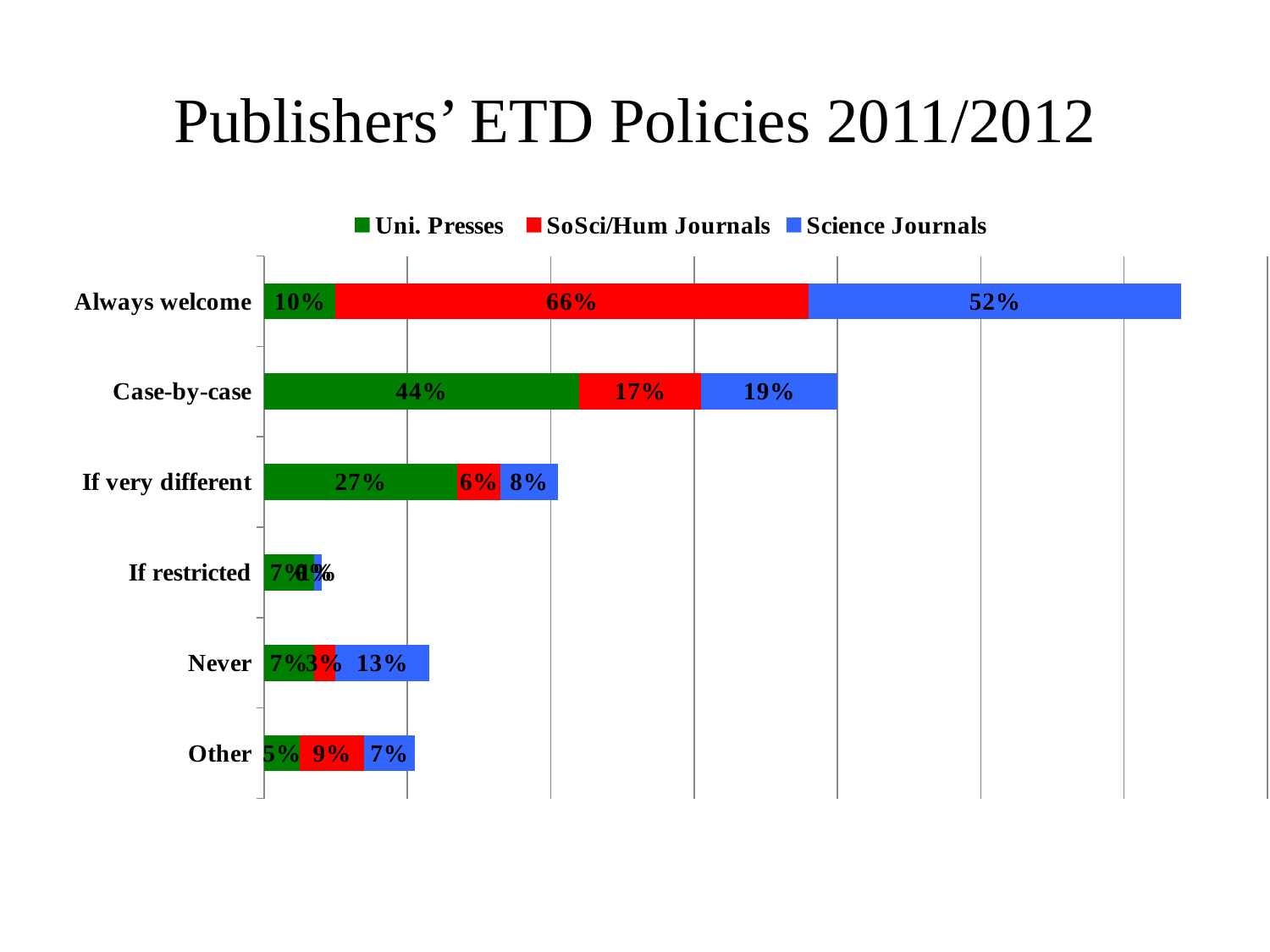
Which category has the highest value for Science Journals? Always welcome What is the value for SoSci/Hum Journals in the Always welcome category? 66% What is the value for Science Journals in the Never category? 13% Which is larger in the Other category: the SoSci/Hum Journals value or the Science Journals value? SoSci/Hum Journals What is the value for Science Journals in the If very different category? 8% How many series does the legend list? 3 What is the value for Uni. Presses in the Case-by-case category? 44% How many policy categories are shown on the chart? 6 Which category has the highest value for Uni. Presses? Case-by-case What is the difference between the Science Journals and Uni. Presses values in the Always welcome category? 42% What kind of chart is shown on the slide? Stacked bar chart What is the total of the stacked bar for the Case-by-case category? 80%